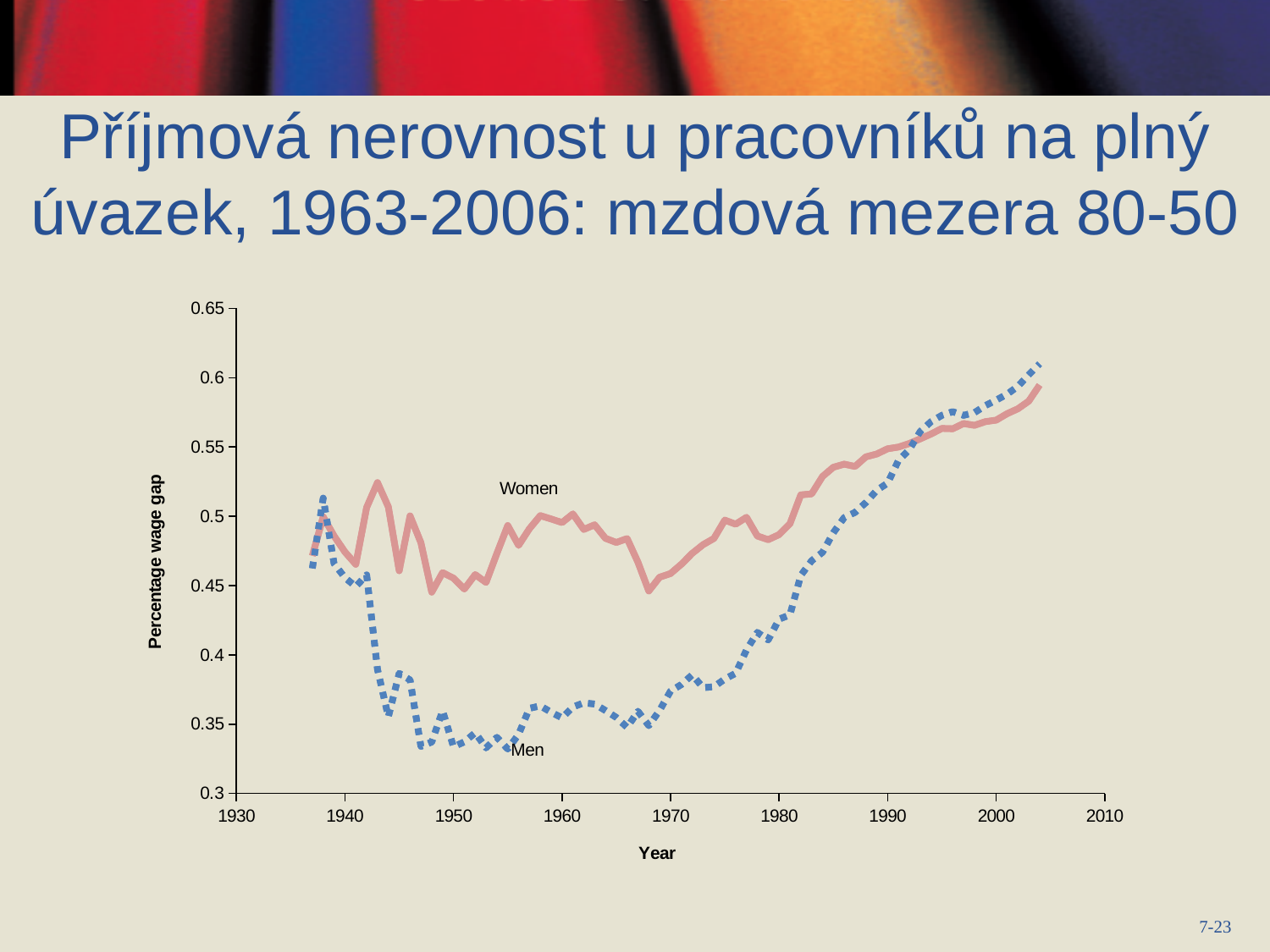
Is the value for Women in 2000 greater or less than 0.55? greater How many series are plotted on the chart? 2 Is the value for Men in 1980 greater or less than 0.4? greater Is the value for Men around 1948 greater or less than 0.35? less Does the Men series rise or fall between 1960 and 2000? rise What kind of chart is shown on the slide? line chart In 1980, which series has the higher value, Women or Men? Women What are the names of the two series plotted on the chart? Women and Men What is the label of the vertical axis? Percentage wage gap In 1960, which series has the higher value, Women or Men? Women